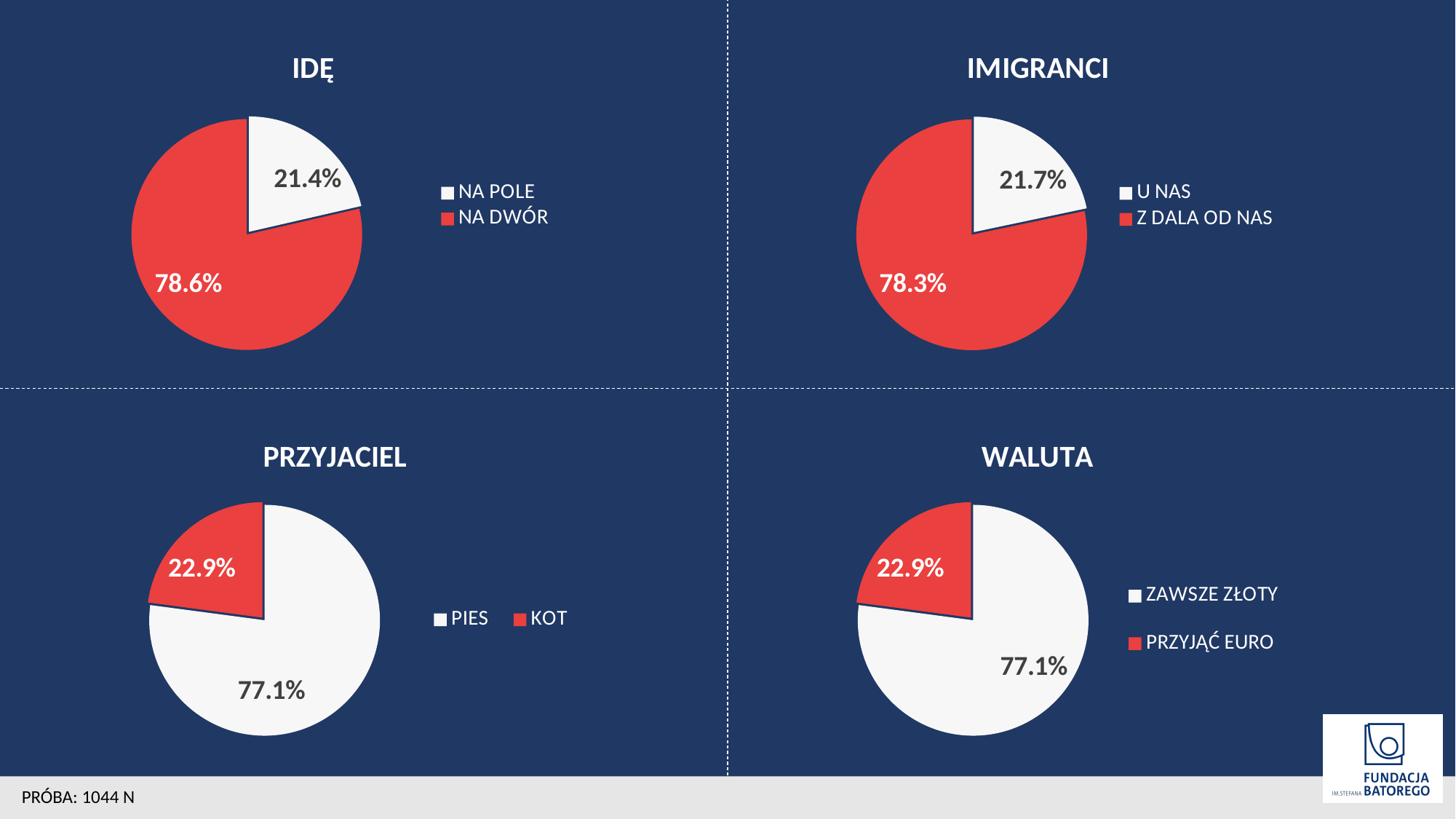
In the "IDĘ" chart, what is the difference between the NA DWÓR and NA POLE shares? 57.2% In the "IMIGRANCI" chart, what share is labelled for Z DALA OD NAS? 78.3% In the "PRZYJACIEL" chart, which category has the largest slice? PIES In the "PRZYJACIEL" chart, what share is labelled for PIES? 77.1% In the "IDĘ" chart, what share is labelled for NA POLE? 21.4% In the "WALUTA" chart, which category has the smallest slice? PRZYJĄĆ EURO What kind of chart is the "WALUTA" chart? Pie chart In the "IMIGRANCI" chart, which is larger, U NAS or Z DALA OD NAS? Z DALA OD NAS In the "IDĘ" chart, what share is labelled for NA DWÓR? 78.6% How many categories does the legend of the "PRZYJACIEL" chart list? 2 In the "IMIGRANCI" chart, what share is labelled for U NAS? 21.7% In the "WALUTA" chart, what share is labelled for PRZYJĄĆ EURO? 22.9%